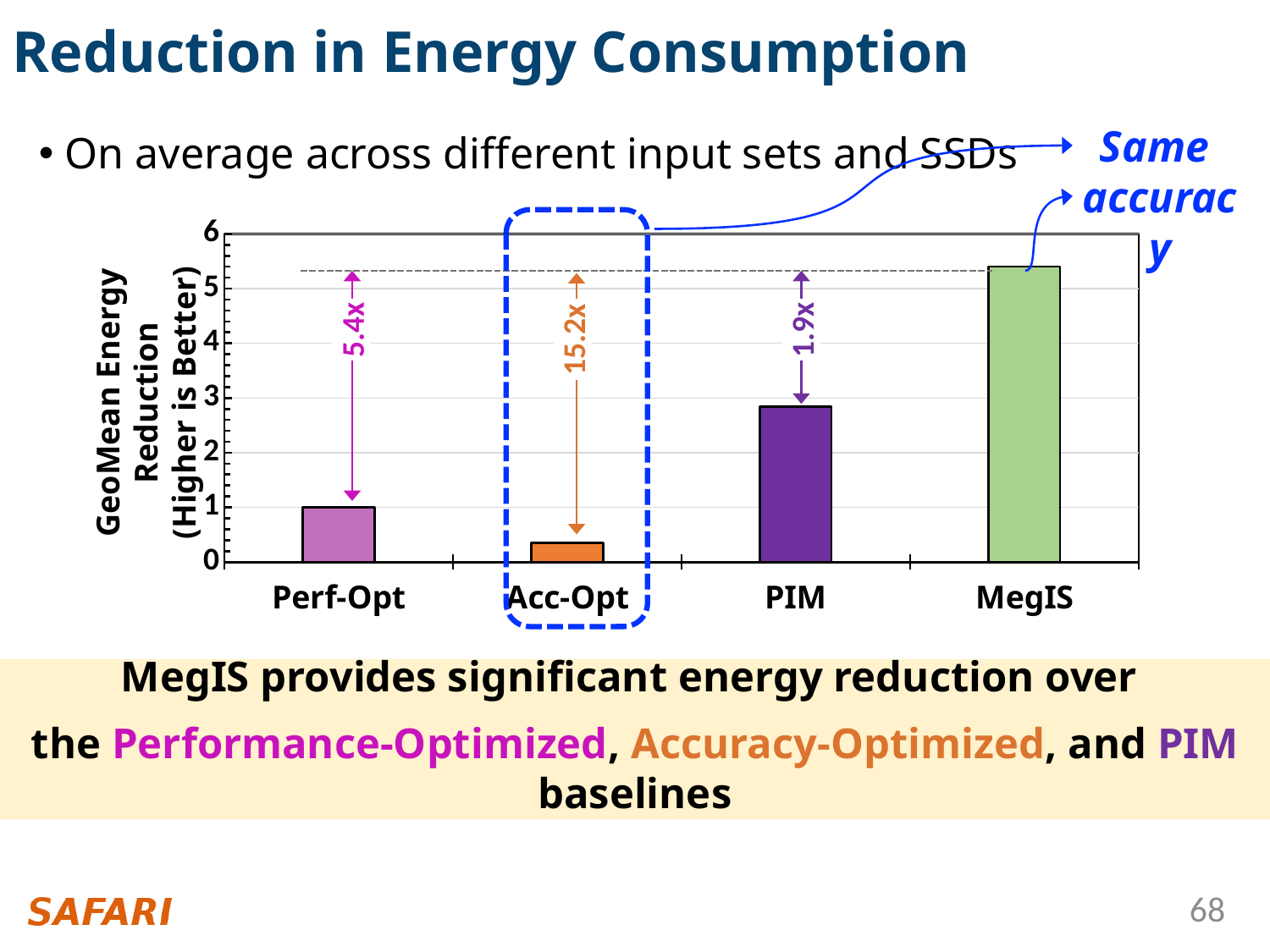
Is the value for MegIS greater or less than 5? greater What is the label of the y axis of the chart? GeoMean Energy Reduction (Higher is Better) What improvement factor is annotated between the Acc-Opt bar and the MegIS level? 15.2x What is the GeoMean Energy Reduction value for Perf-Opt? 1 Which has a larger GeoMean Energy Reduction, PIM or Perf-Opt? PIM What kind of chart is shown on the slide? bar chart Which has a larger GeoMean Energy Reduction, Acc-Opt or MegIS? MegIS Which category has the highest GeoMean Energy Reduction? MegIS Is the value for Acc-Opt greater or less than 1? less Which category has the lowest GeoMean Energy Reduction? Acc-Opt Is the value for PIM greater or less than 2? greater How many categories are shown on the x axis of the chart? 4